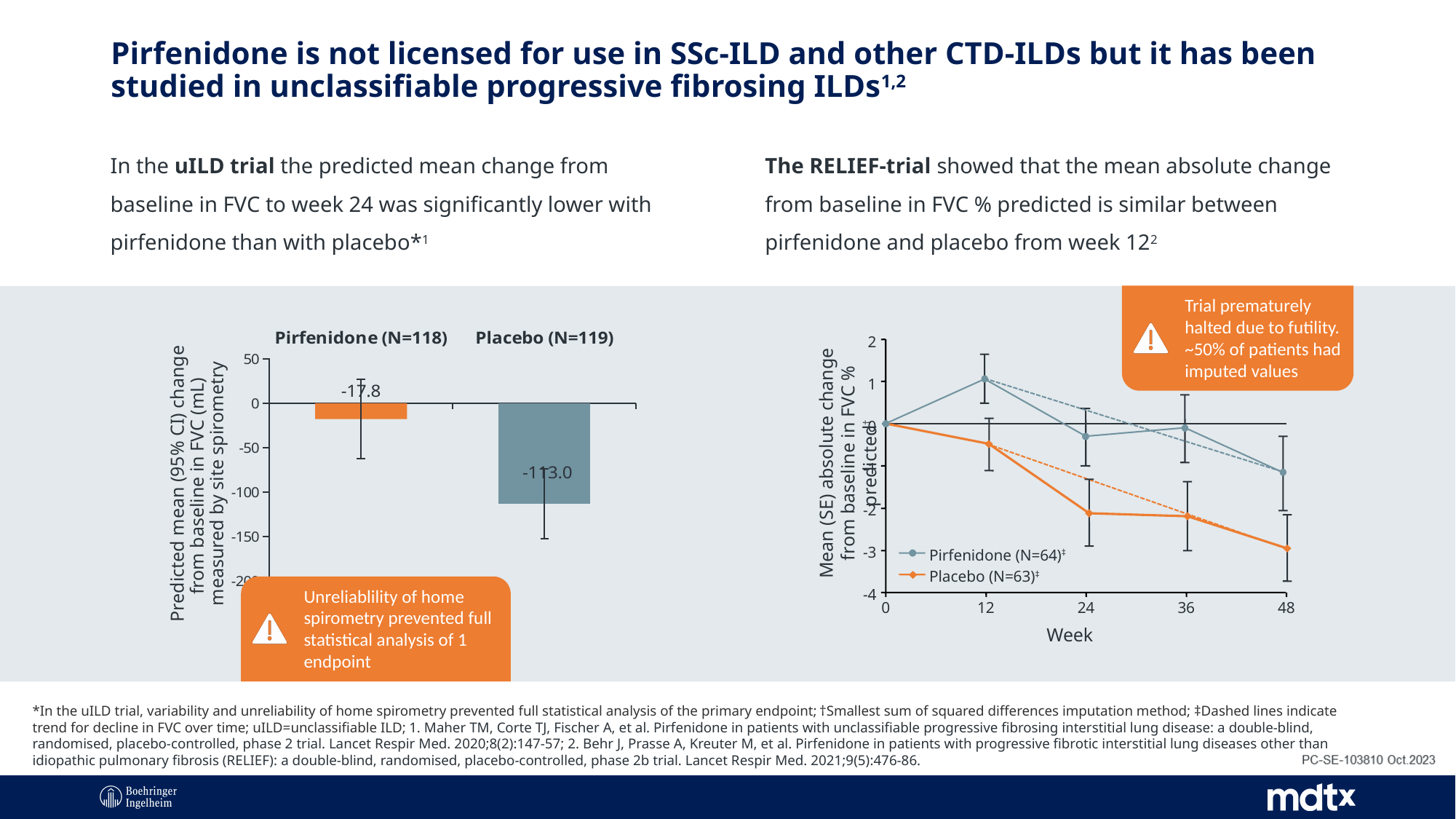
On the left bar chart, is the value for Placebo greater or less than -100? less On the left bar chart, which group shows the larger decline in FVC, Pirfenidone or Placebo? Placebo On the right line chart, how many series does the legend list? 2 On the right line chart, does the Placebo line rise or fall from week 0 to week 48? fall On the left bar chart, what is the predicted mean change from baseline in FVC for Pirfenidone (N=118)? -17.8 What kind of chart is the left chart on the slide? bar chart On the left bar chart, what is the difference between the Placebo and Pirfenidone values? 95.2 On the left bar chart, how many bars are plotted? 2 On the right line chart, is the value for Placebo at week 48 greater or less than -2? less What kind of chart is the right chart on the slide? line chart On the left bar chart, what is the predicted mean change from baseline in FVC for Placebo (N=119)? -113.0 On the right line chart, how many week time points are shown on the x axis? 5